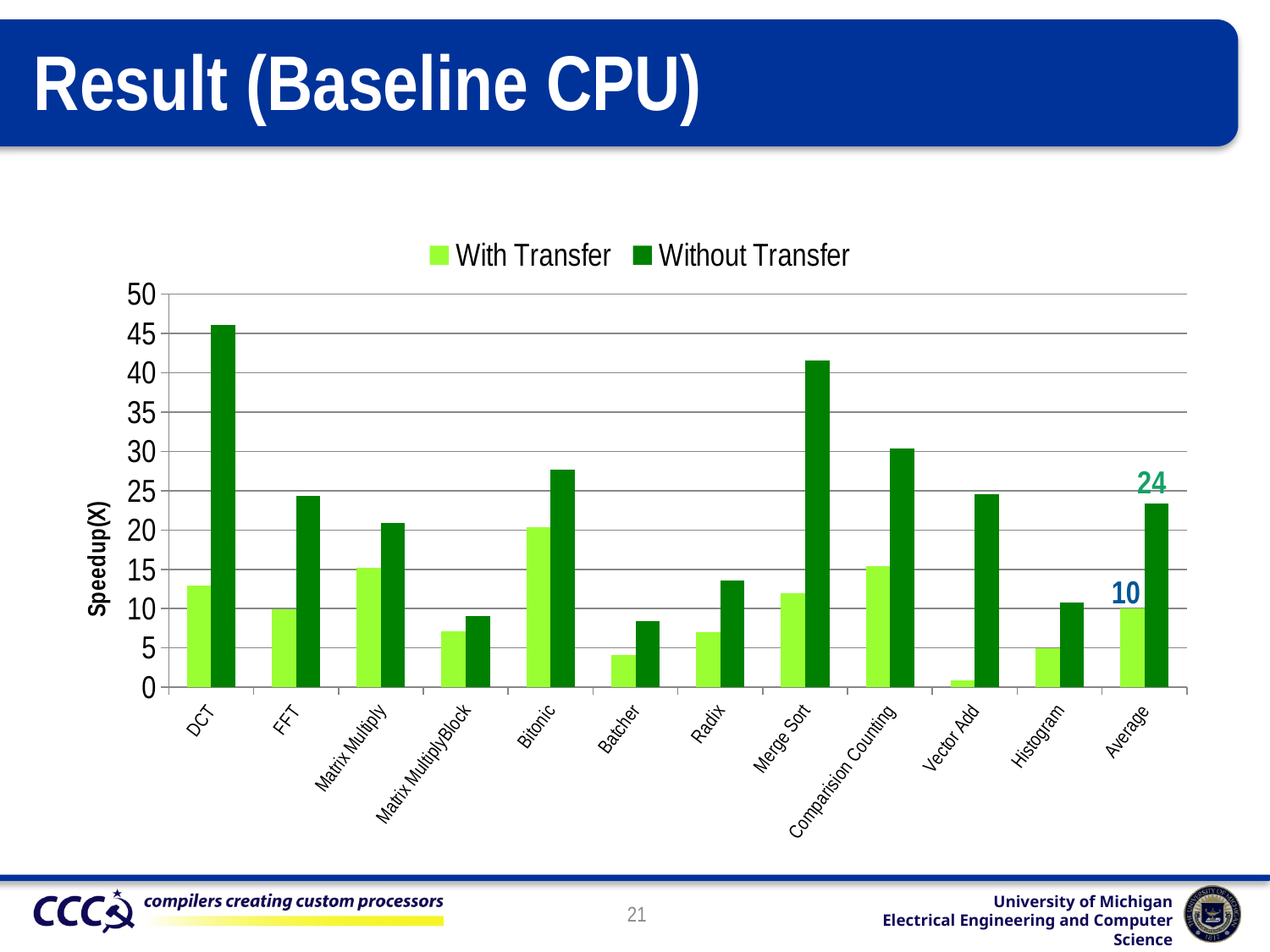
Which benchmark has the highest With Transfer speedup? Bitonic Which benchmark has the highest Without Transfer speedup? DCT What is the difference between the Without Transfer and With Transfer values for Average? 14 What is the Without Transfer speedup for Average? 24 What is the With Transfer speedup for Average? 10 Is the Without Transfer value for Merge Sort greater or less than 40? greater How many series does the legend list? 2 What is the label of the y axis? Speedup(X) Which is larger for Vector Add: the With Transfer value or the Without Transfer value? Without Transfer Which benchmark has the lowest With Transfer speedup? Vector Add How many benchmark categories are shown on the x axis? 12 Is the With Transfer value for Batcher greater or less than 5? less